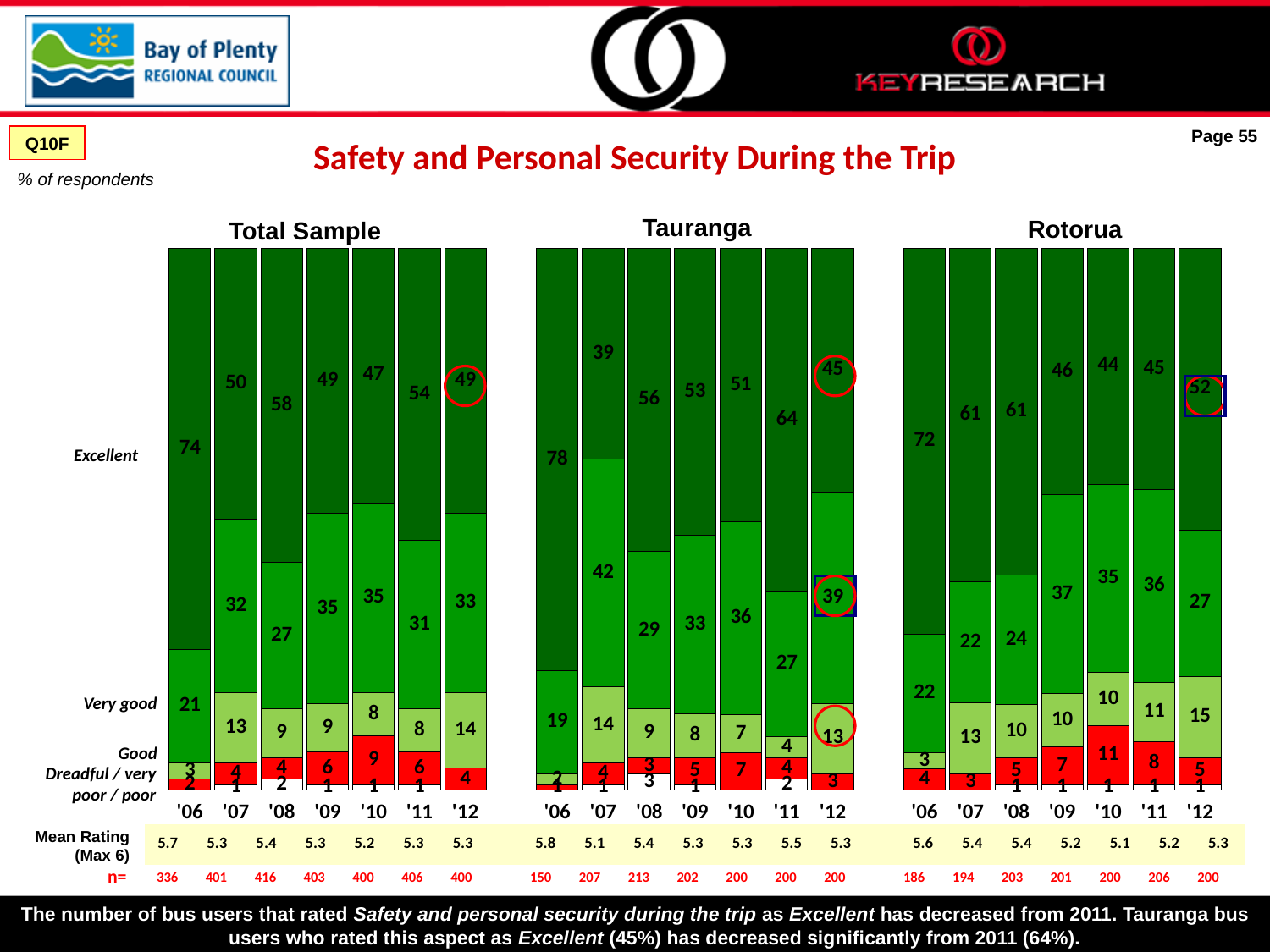
What type of chart is used for the Total Sample, Tauranga and Rotorua data? Stacked bar chart How many years are shown on the x axis of each chart? 7 In the Tauranga chart, which year has the lowest Excellent value? '07 In the Total Sample chart, what is the difference between the Excellent values for '08 and '12? 9 What is the title of the slide's chart section? Safety and Personal Security During the Trip In the Rotorua chart, what is the Very good value for '09? 37 In the Total Sample chart, what percentage of respondents rated safety and personal security as Excellent in '06? 74 In the Rotorua chart, which is larger: the Excellent value for '12 or the Excellent value for '11? '12 In the Tauranga chart, what is the Excellent value for '11? 64 In the Tauranga chart, by how many percentage points did the Excellent value fall from '11 to '12? 19 In the Tauranga chart, which year has the highest Excellent value? '06 In the Rotorua chart, does the Excellent value rise or fall from '06 to '09? Fall